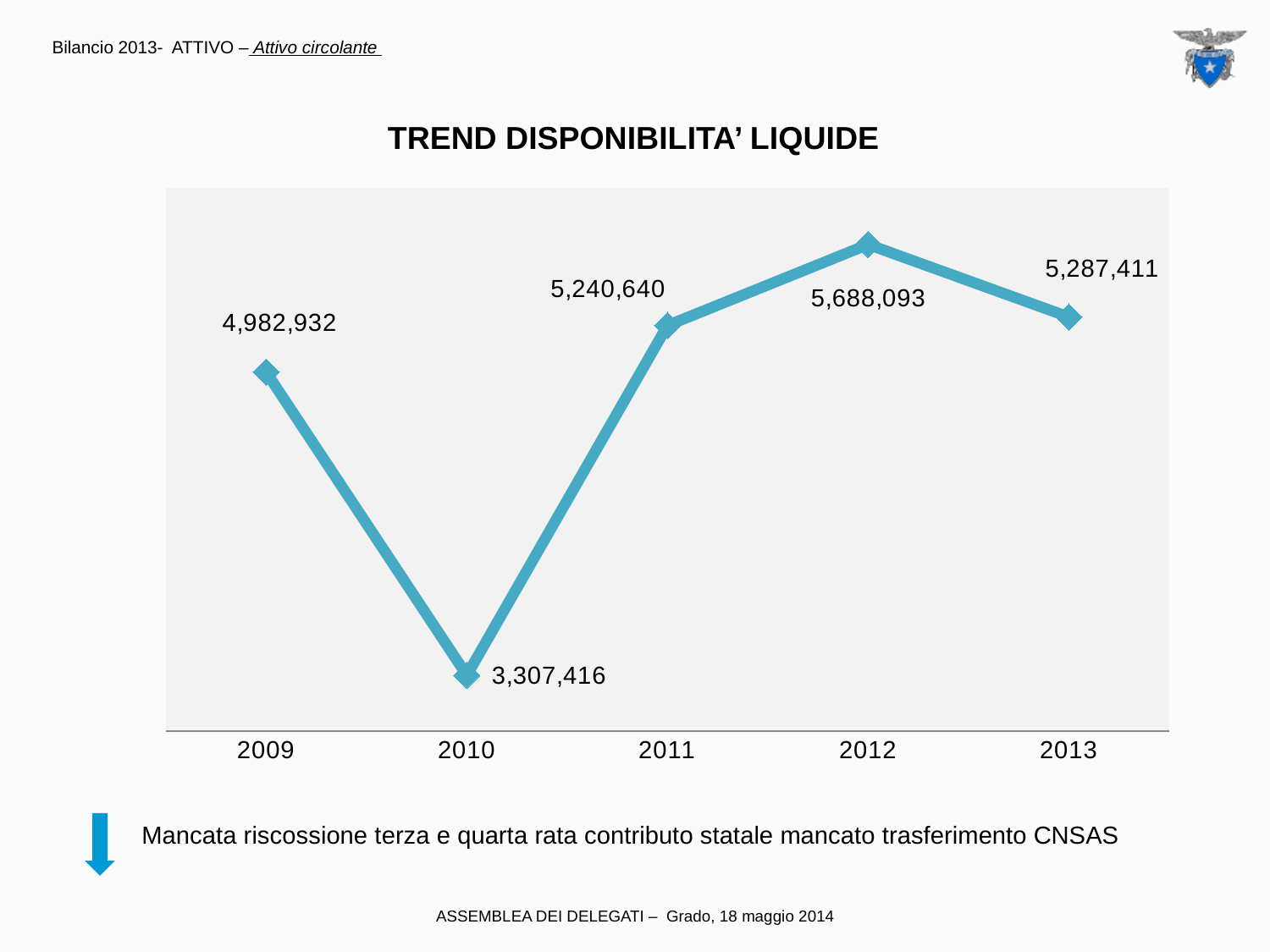
What is the value for 2010? 3,307,416 What is the value for 2012? 5,688,093 Which year has the lowest value? 2010 What is the difference between the values for 2012 and 2013? 400,682 Which year has the highest value? 2012 Which is larger, the value for 2009 or the value for 2011? 2011 What is the value for 2011? 5,240,640 What is the value for 2013? 5,287,411 How many years are plotted on the chart? 5 What is the value for 2009? 4,982,932 What is the title of the chart? TREND DISPONIBILITA' LIQUIDE What kind of chart is shown? line chart